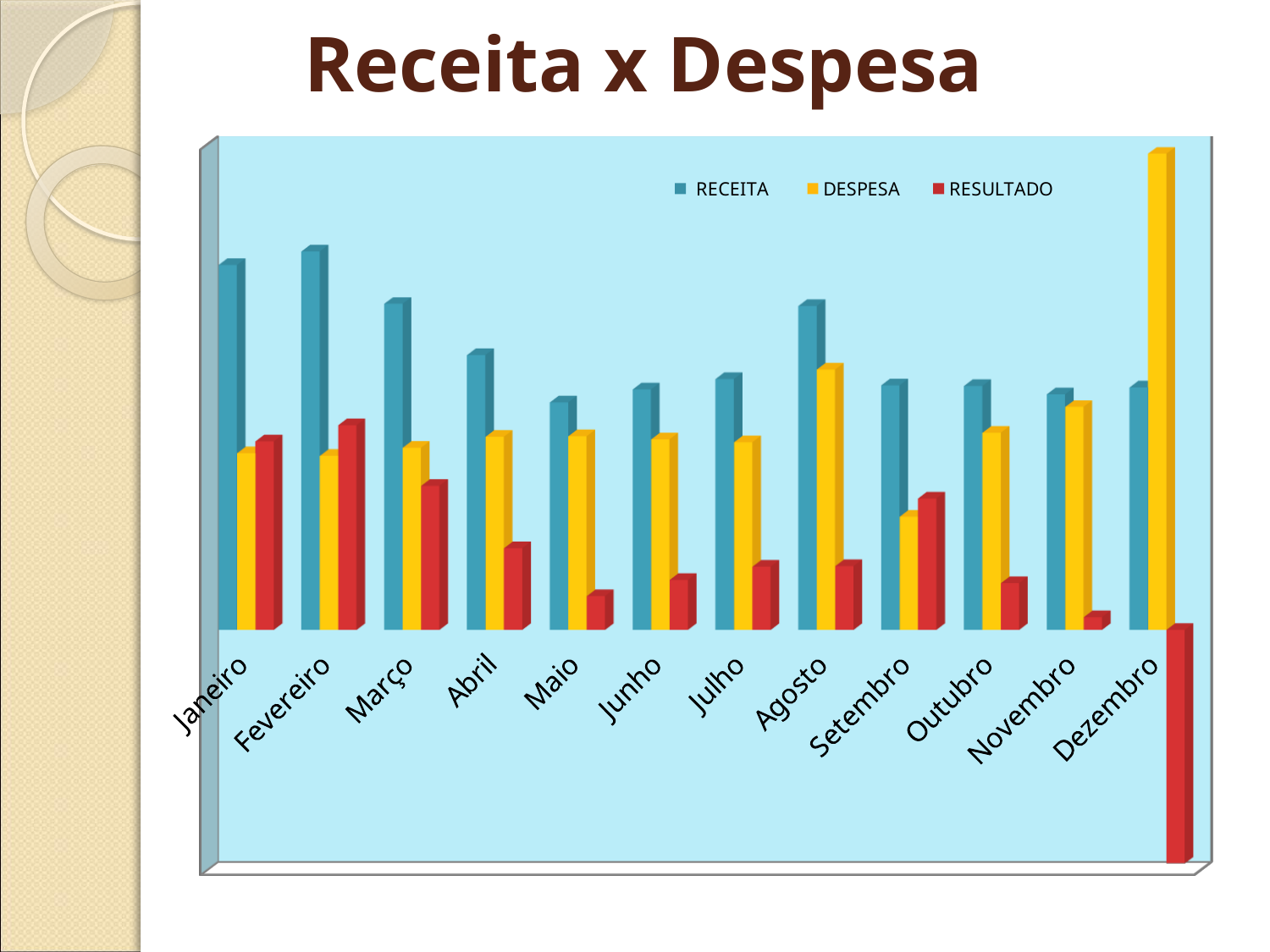
Is RECEITA larger in Janeiro or in Maio? Janeiro In Dezembro, which is larger, RECEITA or DESPESA? DESPESA What is the title of the slide? Receita x Despesa How many months are shown on the x axis? 12 In Agosto, which is larger, RECEITA or DESPESA? RECEITA In which month is RESULTADO highest? Fevereiro In which month is DESPESA highest? Dezembro In which month is DESPESA lowest? Setembro What kind of chart is shown on the slide? Bar chart Does RECEITA rise or fall from Fevereiro to Maio? Fall In which month is RESULTADO lowest? Dezembro How many series does the legend list? 3